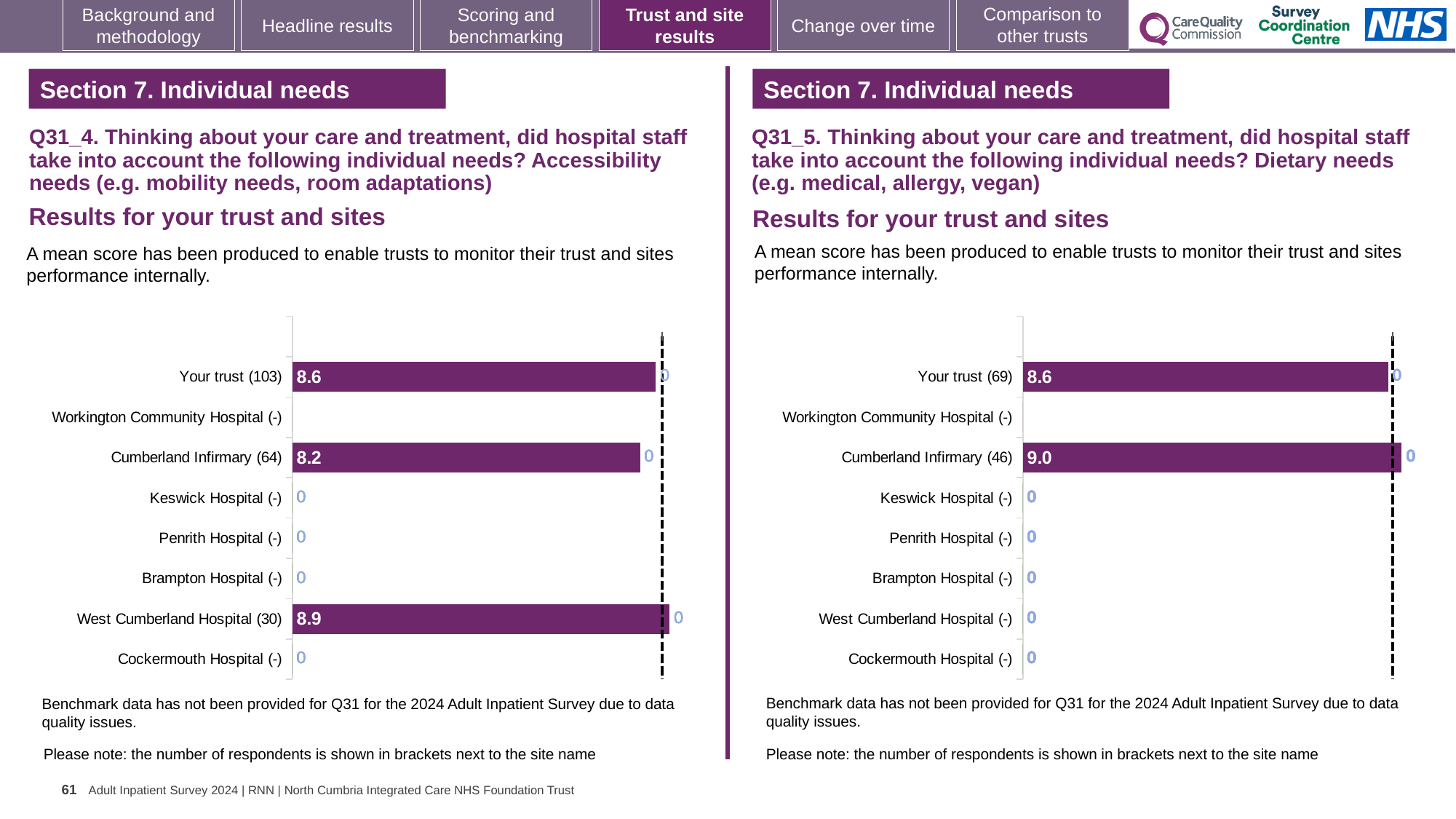
On the Q31_4 Accessibility needs chart (left), what is the mean score for Your trust (103)? 8.6 How many site categories are listed on the y axis of the Q31_4 Accessibility needs chart (left)? 8 On the Q31_4 Accessibility needs chart (left), which site with a plotted bar has the highest mean score? West Cumberland Hospital (30) On the Q31_4 Accessibility needs chart (left), what is the mean score for Cumberland Infirmary (64)? 8.2 What type of chart is used for the Q31_5 Dietary needs results (right)? Bar chart On the Q31_5 Dietary needs chart (right), what is the mean score for Your trust (69)? 8.6 On the Q31_4 Accessibility needs chart (left), what is the difference between the West Cumberland Hospital (30) score and the Cumberland Infirmary (64) score? 0.7 On the Q31_5 Dietary needs chart (right), what is the difference between the Cumberland Infirmary (46) score and the Your trust (69) score? 0.4 On the Q31_4 Accessibility needs chart (left), what is the mean score for West Cumberland Hospital (30)? 8.9 On the Q31_5 Dietary needs chart (right), what is the mean score for Cumberland Infirmary (46)? 9.0 On the Q31_4 Accessibility needs chart (left), which site with a plotted bar has the lowest mean score? Cumberland Infirmary (64) On the Q31_5 Dietary needs chart (right), which is larger: the score for Your trust (69) or the score for Cumberland Infirmary (46)? Cumberland Infirmary (46)